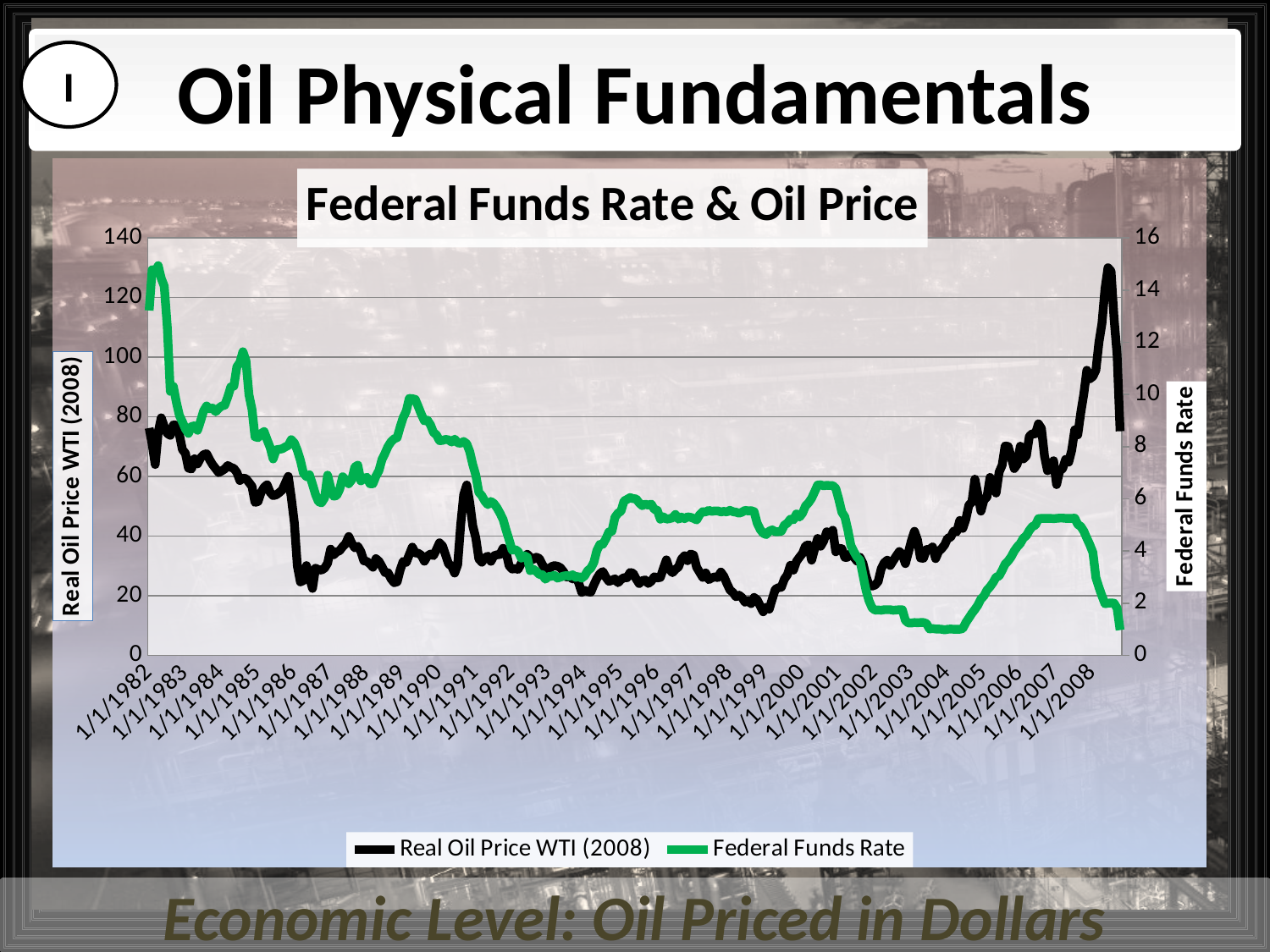
In which year does the Real Oil Price WTI (2008) line reach its highest point? 2008 Is the Real Oil Price WTI (2008) at 1/1/1982 greater or less than 60? greater What kind of chart is shown on the slide? line chart What is the title of the chart? Federal Funds Rate & Oil Price Which series is drawn in green? Federal Funds Rate Is the Real Oil Price WTI (2008) value at 1/1/1999 greater or less than 20? less Is the Federal Funds Rate at 1/1/2004 greater or less than 2? less How many series does the legend list? 2 Does the Real Oil Price WTI (2008) overall rise or fall between 1/1/2002 and 1/1/2008? rise Does the Federal Funds Rate overall rise or fall between 1/1/1982 and 1/1/1994? fall